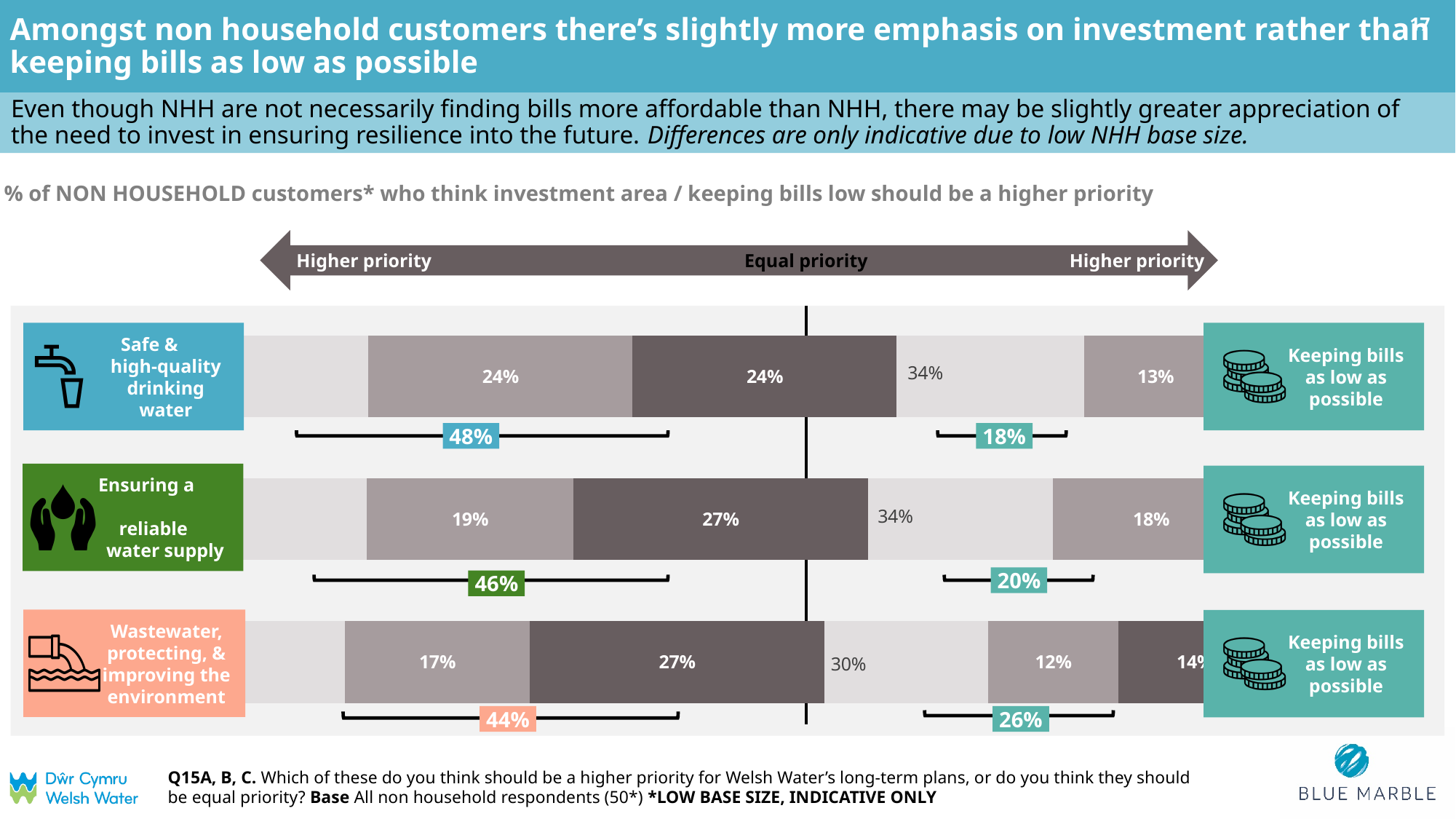
What is the difference between the combined share prioritising wastewater, protecting & improving the environment (44%) and the combined share prioritising keeping bills low for that area (26%)? 18 percentage points How many investment areas are shown in the chart? 3 Which investment area has the highest combined share of non household customers saying it should be a higher priority than keeping bills low? Safe & high-quality drinking water What percentage of non household customers give equal priority to safe & high-quality drinking water and keeping bills low? 34% What percentage of non household customers give equal priority to wastewater, protecting & improving the environment and keeping bills low? 30% What label appears at the centre of the arrow above the chart? Equal priority What type of chart is used on the slide? Bar chart What percentage of non household customers think keeping bills as low as possible should be a higher priority than ensuring a reliable water supply (the combined net figure)? 20% What percentage of non household customers think safe & high-quality drinking water should be a higher priority (the combined net figure)? 48% Which investment area has the lowest combined share of non household customers saying it should be a higher priority than keeping bills low? Wastewater, protecting, & improving the environment Is the combined share prioritising ensuring a reliable water supply (46%) larger or smaller than the combined share prioritising keeping bills low for that area (20%)? Larger For which investment area is the combined share favouring keeping bills low the highest? Wastewater, protecting, & improving the environment